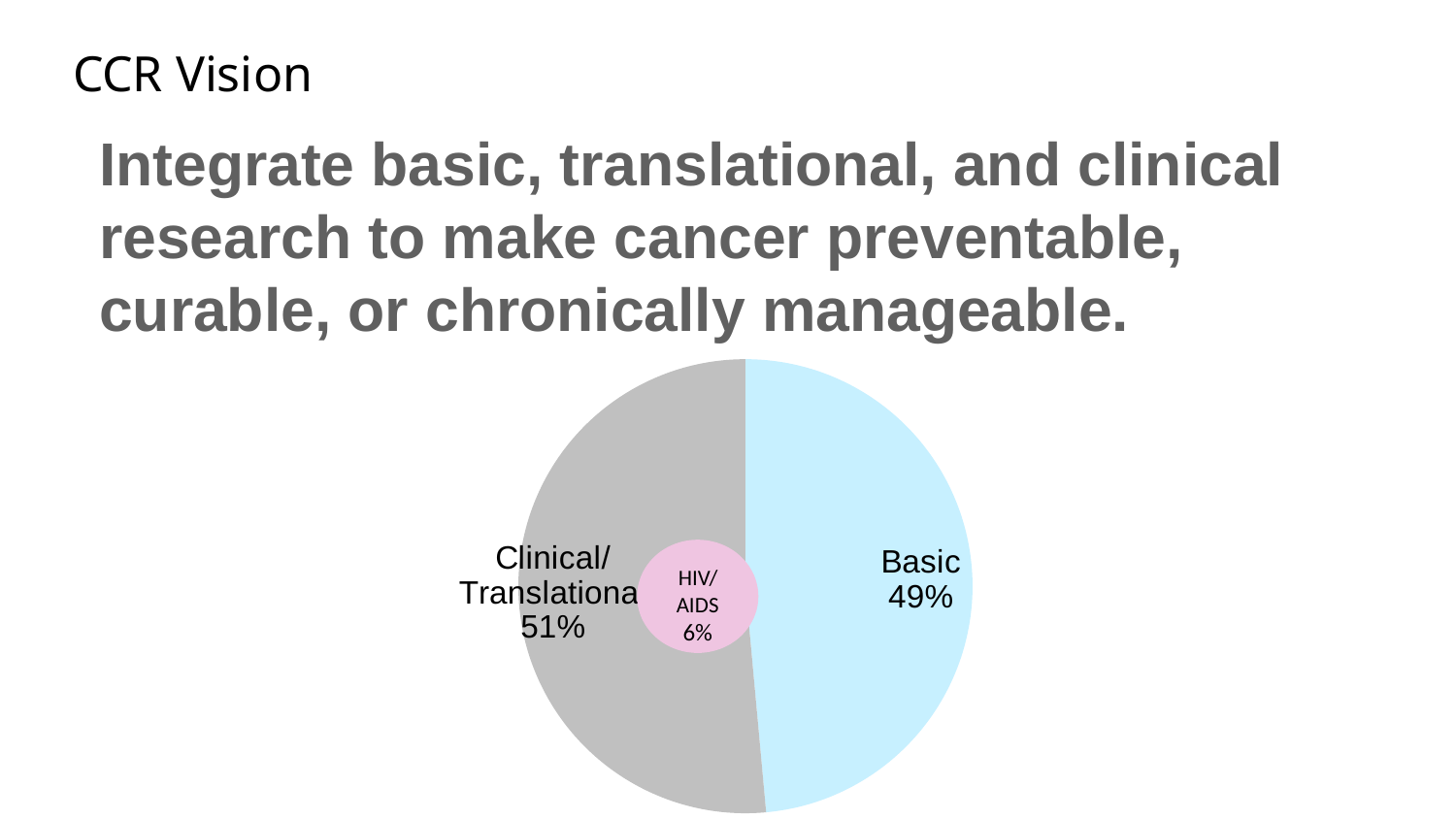
What share of the pie is labelled Clinical/Translational? 51% What percentage is shown for HIV/AIDS in the small circle at the centre of the pie? 6% Which slice of the pie is the largest? Clinical/Translational How many slices does the pie chart have? 2 What colour is the Basic slice of the pie? Light blue What kind of chart is shown on the slide? Pie chart Which slice of the pie is the smallest? Basic Which is larger, the Basic slice or the Clinical/Translational slice? Clinical/Translational What colour is the Clinical/Translational slice of the pie? Grey What share of the pie is labelled Basic? 49% What is the difference in percentage points between the Clinical/Translational slice and the Basic slice? 2 percentage points